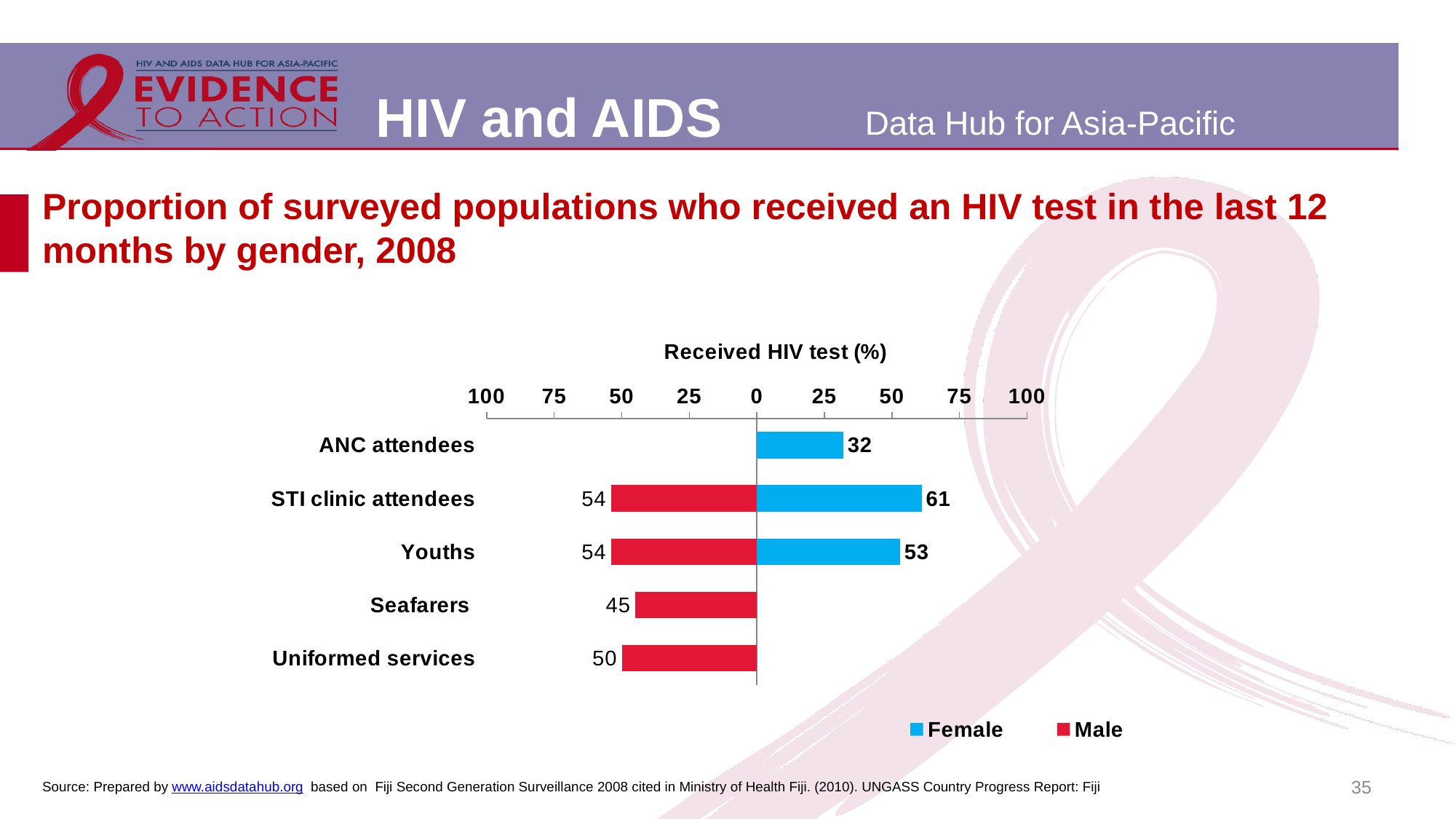
What is the Male value for Seafarers? 45 What is the Female value for ANC attendees? 32 How many categories are shown on the chart? 5 Which category has the lowest Male value among those with a Male bar? Seafarers What is the Female value for STI clinic attendees? 61 How many series does the legend list? 2 What kind of chart is shown on the slide? Bar chart What is the difference between the Female and Male values for STI clinic attendees? 7 For Youths, is the Male value or the Female value larger? Male Which category has the highest Female value? STI clinic attendees What colour represents the Male series in the chart? Red What is the Male value for Uniformed services? 50